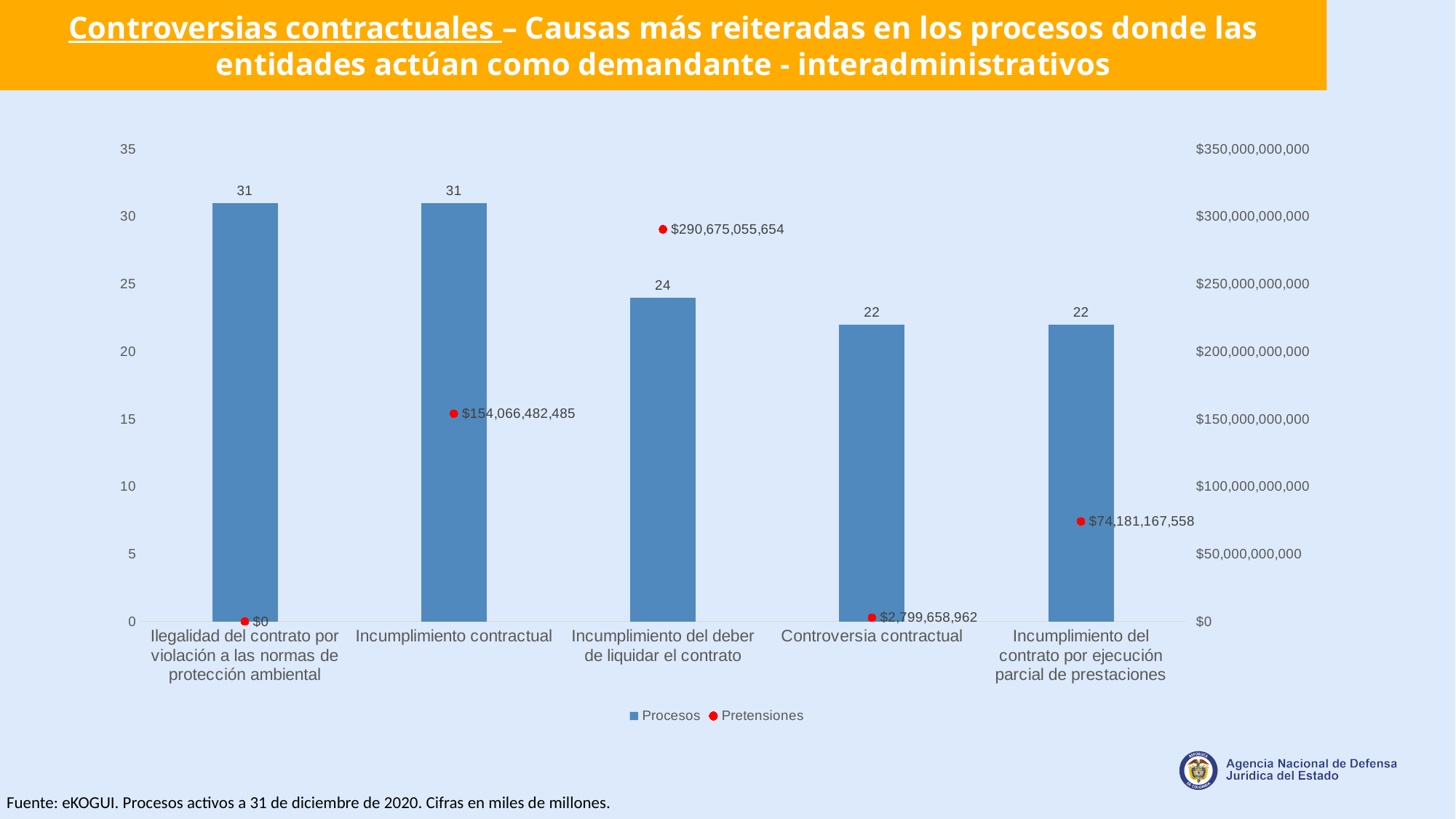
How many Procesos are shown for Incumplimiento del deber de liquidar el contrato? 24 What are the two series named in the legend? Procesos and Pretensiones Is the Pretensiones value for Incumplimiento del contrato por ejecución parcial de prestaciones greater or less than $100,000,000,000? less Which category has the highest Pretensiones value? Incumplimiento del deber de liquidar el contrato Which category has the lowest Pretensiones value? Ilegalidad del contrato por violación a las normas de protección ambiental What is the Pretensiones value for Controversia contractual? $2,799,658,962 What is the Pretensiones value for Incumplimiento contractual? $154,066,482,485 Which has more Procesos: Incumplimiento del deber de liquidar el contrato or Incumplimiento del contrato por ejecución parcial de prestaciones? Incumplimiento del deber de liquidar el contrato How many series does the legend list? 2 How many categories are shown on the x axis? 5 What kind of chart is used to show the Procesos series? bar chart What is the difference in Procesos between Incumplimiento contractual and Controversia contractual? 9